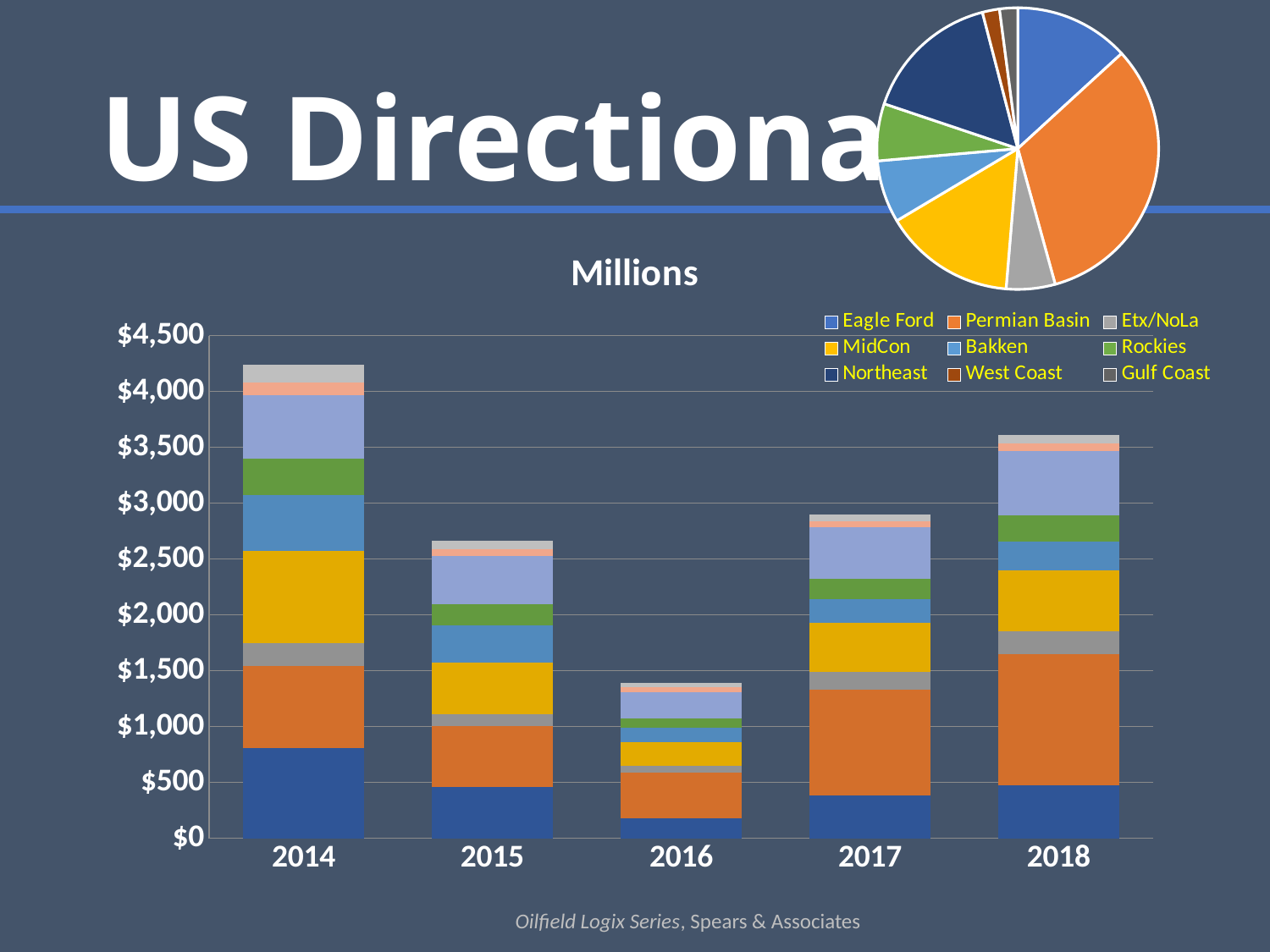
In the "Millions" bar chart, is the total for 2016 greater or less than $1,500? less In the "Millions" bar chart, is the total for 2014 greater or less than $4,000? greater What kind of chart is shown in the top right corner of the slide? pie chart In the "Millions" bar chart, which series is listed first in the legend? Eagle Ford In the "Millions" bar chart, do the stacked bar totals rise or fall from 2016 to 2018? rise What kind of chart is the large chart titled "Millions"? bar chart In the "Millions" bar chart, which year has the tallest stacked bar? 2014 In the "Millions" bar chart, is the total for 2017 larger or smaller than the total for 2018? smaller In the "Millions" bar chart, how many series does the legend list? 9 In the "Millions" bar chart, which year has the shortest stacked bar? 2016 In the "Millions" bar chart, is the total for 2018 greater or less than $3,000? greater In the "Millions" bar chart, how many years are shown on the x axis? 5